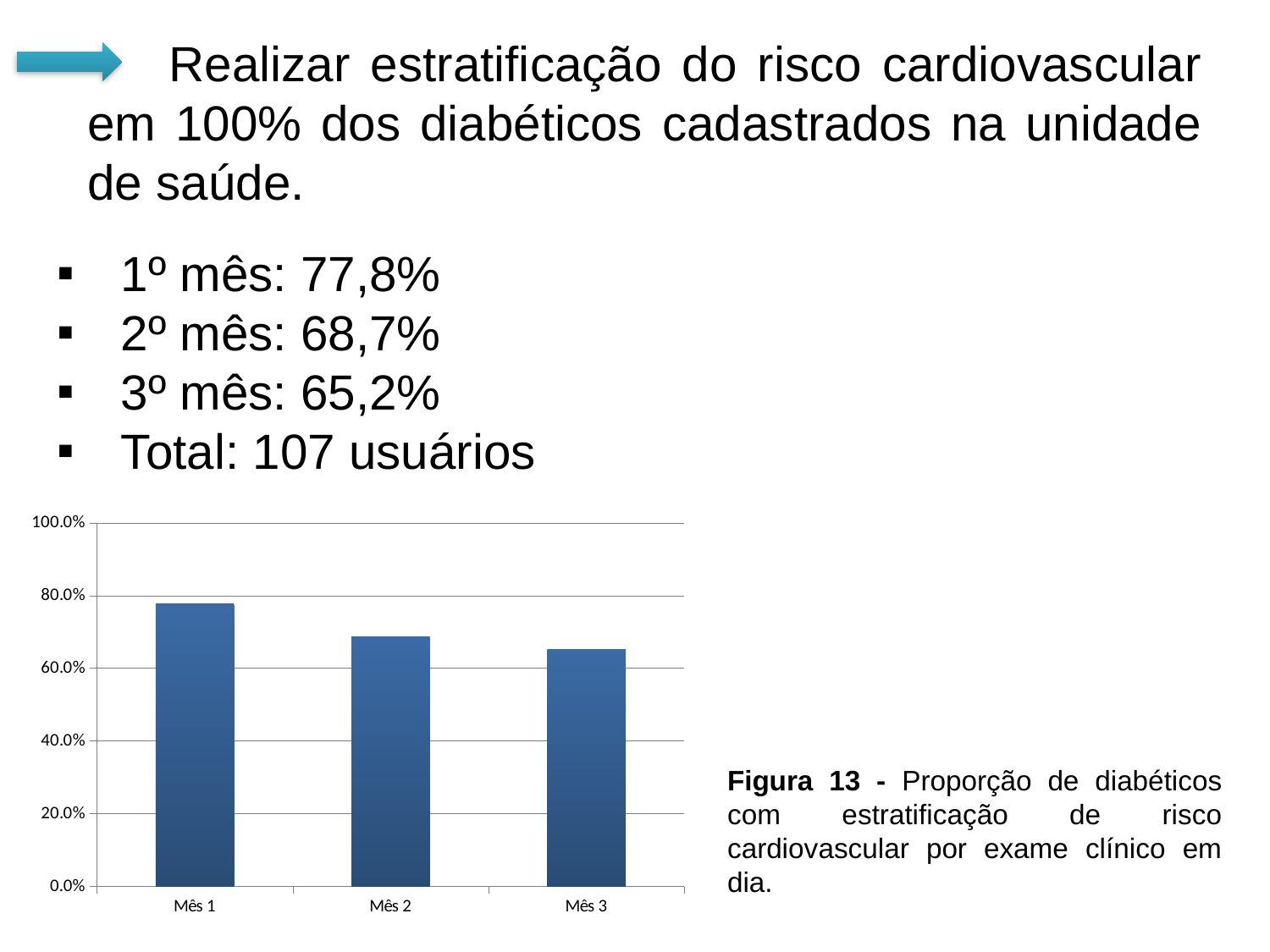
According to the slide text, what proportion was reached in the 1º mês? 77,8% Do the values rise or fall from Mês 1 to Mês 3? fall Which is larger, the bar for Mês 1 or the bar for Mês 2? Mês 1 How many bars (months) does the chart show? 3 Which month has the lowest bar in the chart? Mês 3 Is the value for Mês 1 greater or less than 60.0%? greater Is the value for Mês 2 greater or less than 80.0%? less Which month has the highest bar in the chart? Mês 1 Is the value for Mês 3 greater or less than 80.0%? less According to the slide text, what proportion was reached in the 3º mês? 65,2% What figure number is given in the caption next to the chart? Figura 13 What kind of chart is shown on the slide? bar chart